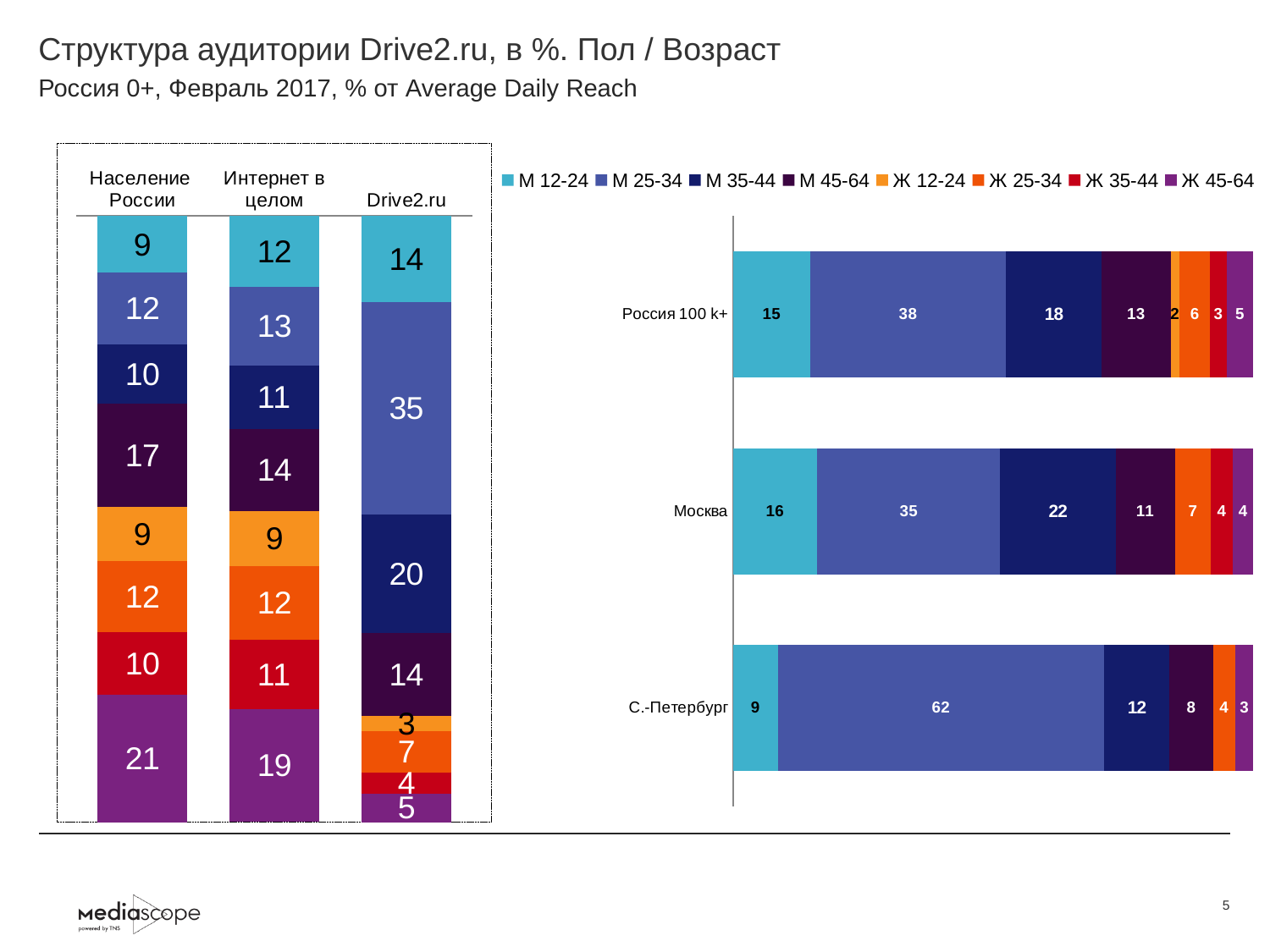
In the right chart, which category has the largest М 25-34 segment? С.-Петербург How many series does the legend on the right list? 8 In the left chart, what is the value of the М 25-34 (blue) segment in the Drive2.ru column? 35 In the right chart, what is the value of the М 25-34 segment for Россия 100 k+? 38 How many categories are shown in the right chart? 3 In the left chart, what is the value of the Ж 45-64 (purple) segment in the Население России column? 21 In the right chart, what is the value of the М 25-34 segment for С.-Петербург? 62 In the right chart, which category has the smallest М 12-24 segment? С.-Петербург In the right chart, what is the difference between the М 25-34 values for С.-Петербург and Москва? 27 In the left chart, which is larger: the М 45-64 segment for Население России or for Интернет в целом? Население России What type of chart is the right chart? Stacked bar chart In the right chart, what is the value of the М 35-44 segment for Москва? 22